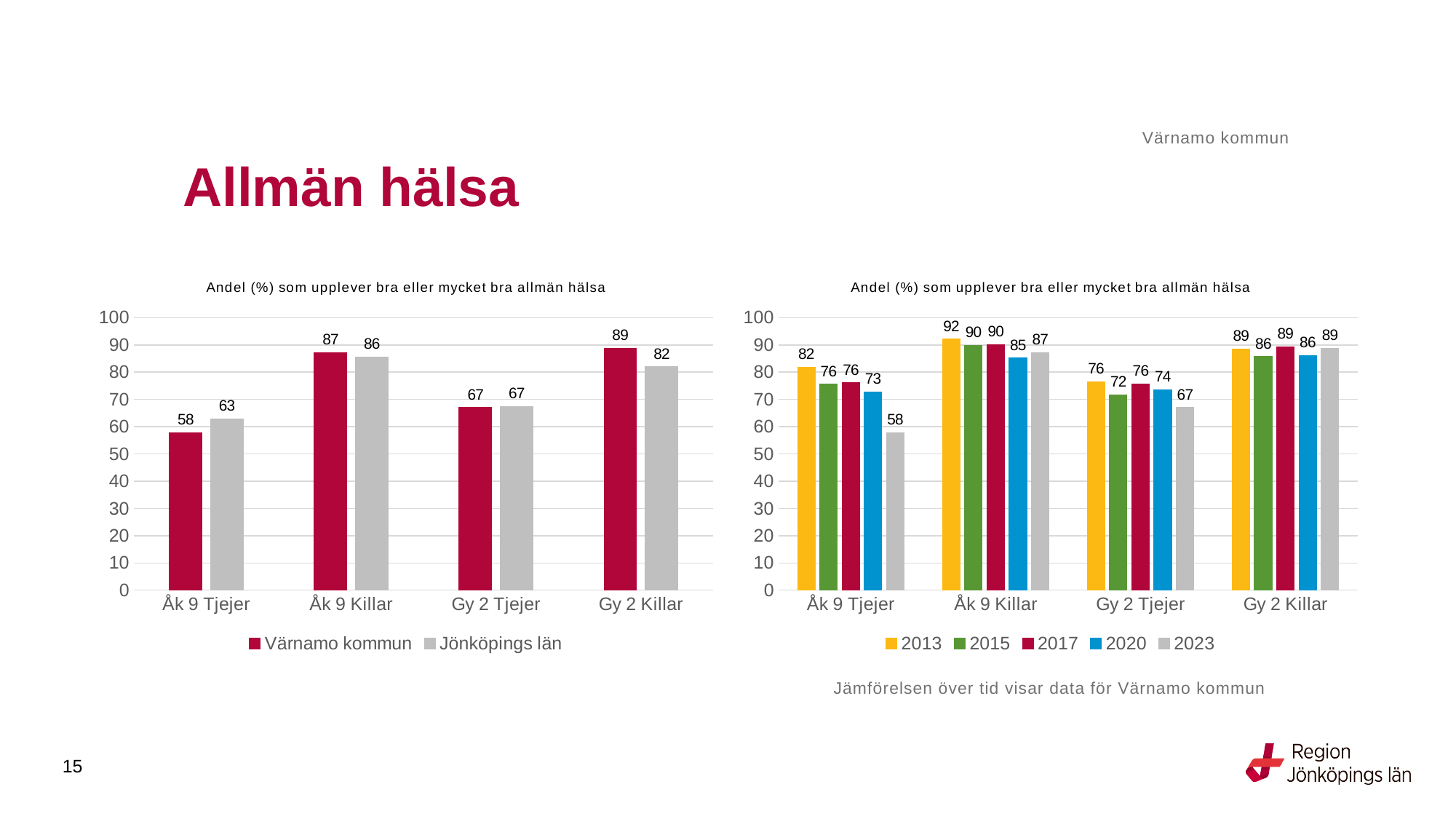
In the right chart, what is the value for 2013 for Åk 9 Killar? 92 In the left chart, how many series does the legend list? 2 In the left chart, what is the value for Värnamo kommun for Åk 9 Tjejer? 58 In the right chart, which year has the lowest value for Åk 9 Tjejer? 2023 In the right chart, is the 2020 value for Gy 2 Killar larger or smaller than the 2023 value for Gy 2 Killar? smaller In the left chart, what is the value for Jönköpings län for Gy 2 Killar? 82 What kind of chart is the right chart? Bar chart In the right chart, what is the value for 2023 for Gy 2 Tjejer? 67 In the left chart, what is the difference between Jönköpings län and Värnamo kommun for Åk 9 Tjejer? 5 In the right chart, how many series does the legend list? 5 In the left chart, which category has the highest value for Värnamo kommun? Gy 2 Killar In the right chart, what is the difference between the 2013 and 2023 values for Åk 9 Tjejer? 24